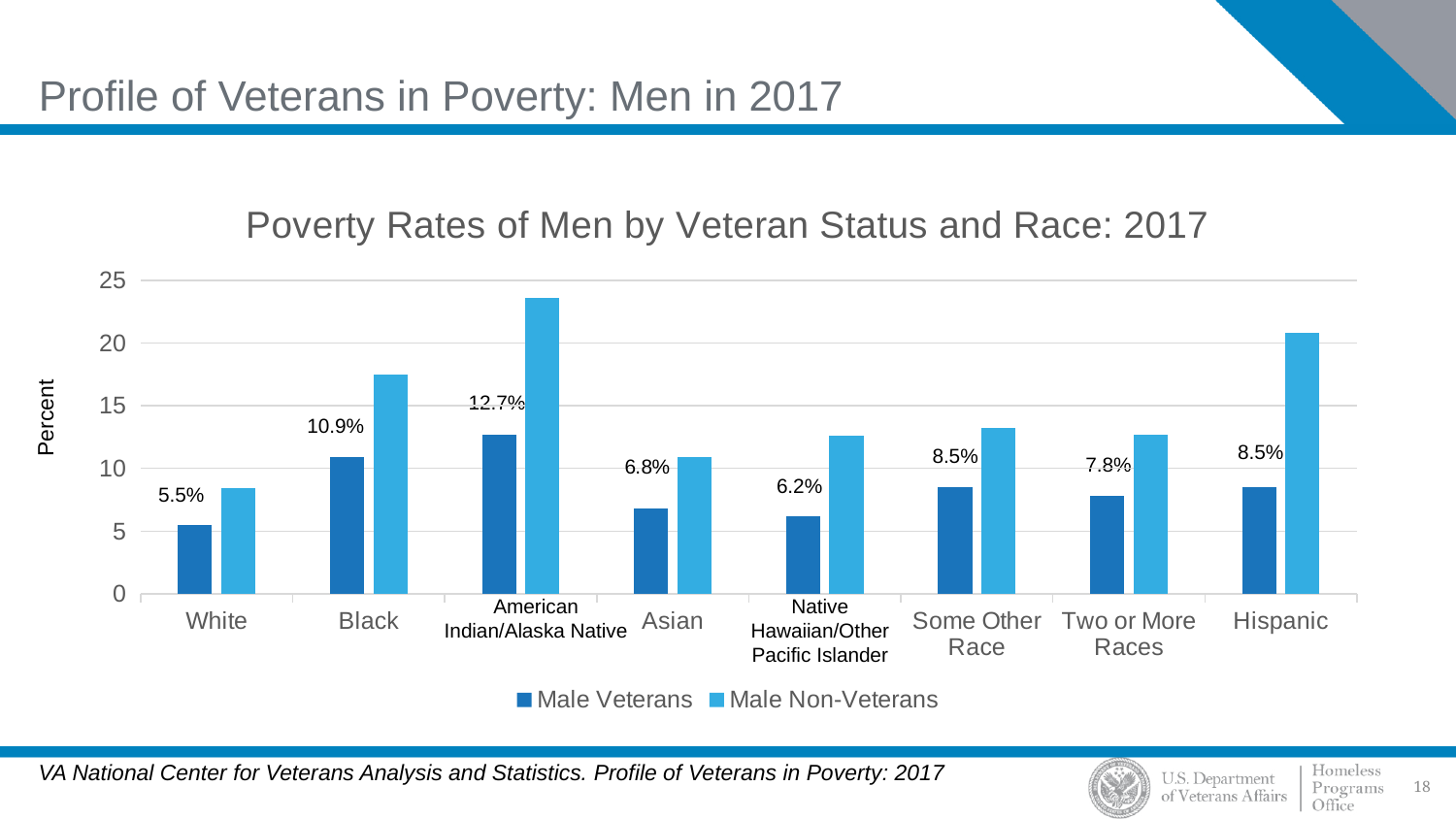
What is the poverty rate for Male Veterans in the White category? 5.5% Which is larger, the Male Veterans poverty rate for Black or for Hispanic? Black How many series does the legend list? 2 What is the difference between the Male Veterans poverty rate for American Indian/Alaska Native and for White? 7.2 percentage points What is the poverty rate for Male Veterans in the Black category? 10.9% How many race categories are shown on the x axis? 8 Which race category has the highest poverty rate for Male Veterans? American Indian/Alaska Native What kind of chart is shown on the slide? Bar chart Is the Male Non-Veterans value for White greater or less than 10? less Is the Male Non-Veterans value for American Indian/Alaska Native greater or less than 20? greater What is the label on the vertical axis of the chart? Percent Which race category has the lowest poverty rate for Male Veterans? White